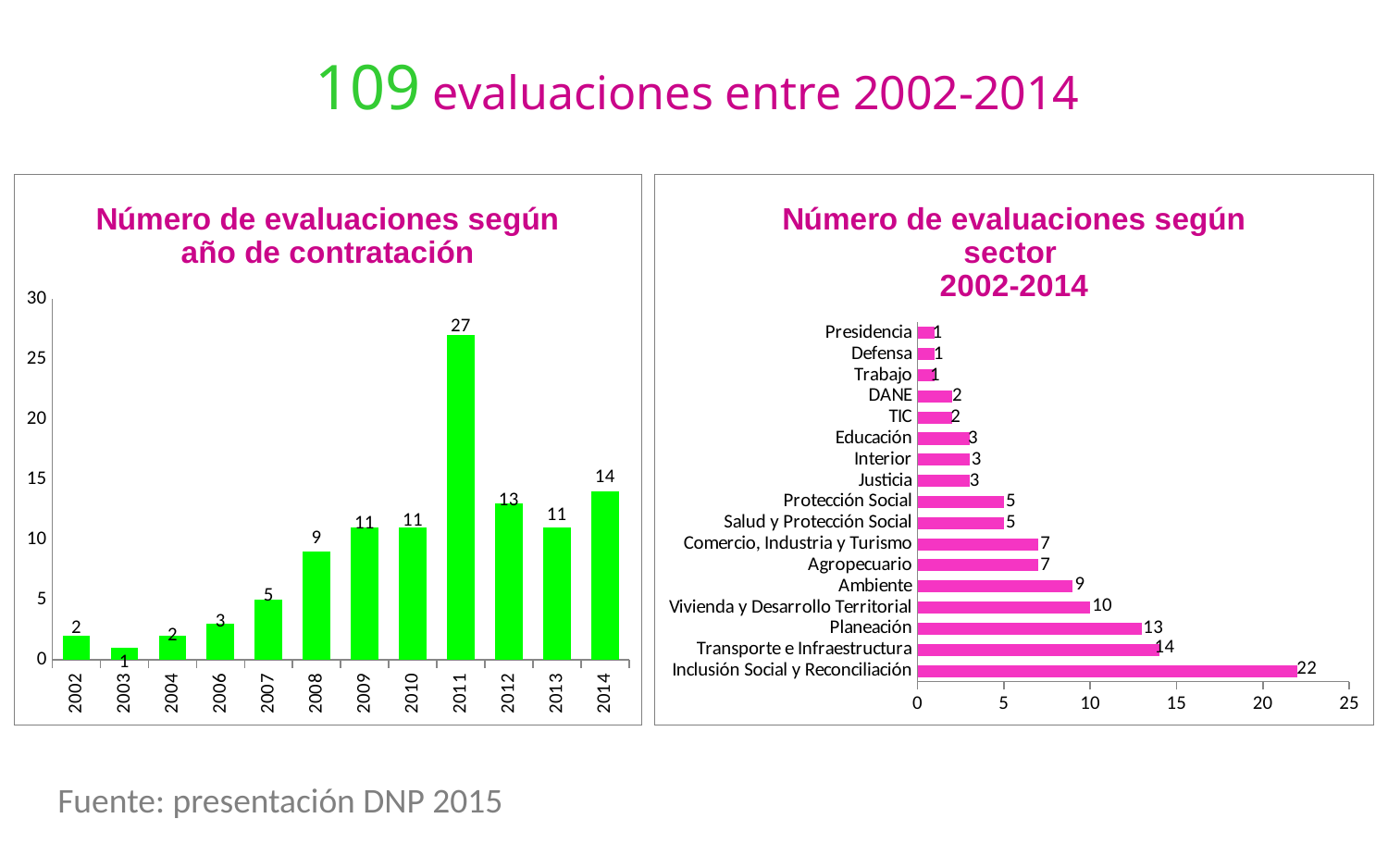
In the chart 'Número de evaluaciones según año de contratación', which year has the lowest value? 2003 In the chart 'Número de evaluaciones según sector 2002-2014', which sector has the highest value? Inclusión Social y Reconciliación In the chart 'Número de evaluaciones según sector 2002-2014', how many sectors are listed? 17 In the chart 'Número de evaluaciones según sector 2002-2014', what is the value for Planeación? 13 In the chart 'Número de evaluaciones según año de contratación', what is the value for 2011? 27 In the chart 'Número de evaluaciones según año de contratación', which is larger, the value for 2008 or the value for 2007? 2008 In the chart 'Número de evaluaciones según año de contratación', what is the difference between the values for 2011 and 2012? 14 In the chart 'Número de evaluaciones según sector 2002-2014', what is the difference between the values for Inclusión Social y Reconciliación and Transporte e Infraestructura? 8 What kind of chart is 'Número de evaluaciones según sector 2002-2014'? Bar chart In the chart 'Número de evaluaciones según año de contratación', is the value for 2014 greater or less than 10? greater What colour are the bars in the chart 'Número de evaluaciones según año de contratación'? Green In the chart 'Número de evaluaciones según año de contratación', how many years are shown on the x axis? 12